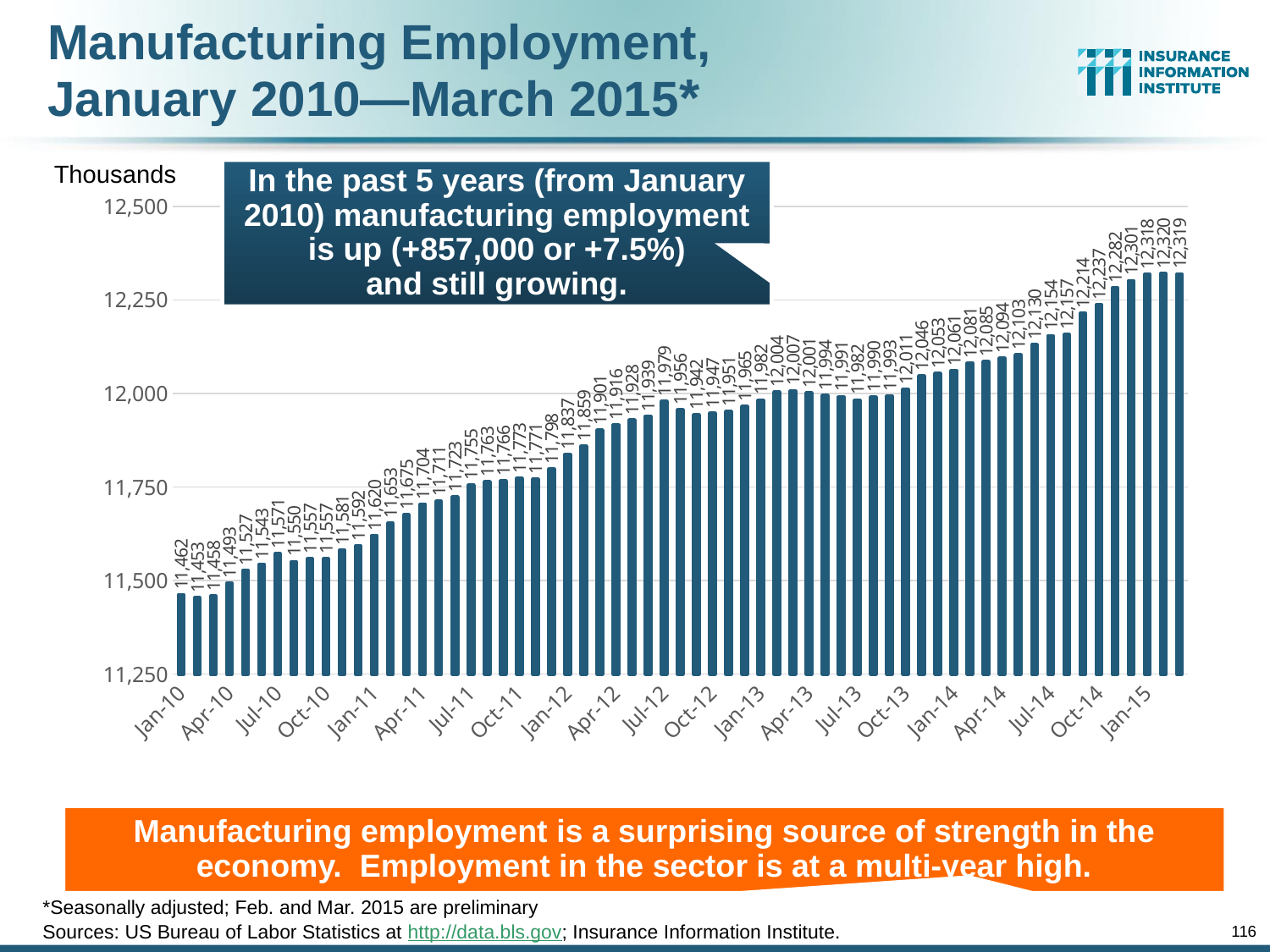
What kind of chart is shown on the slide? bar chart What is the difference between the last bar (March 2015, 12,319) and the first bar (Jan-10, 11,462)? 857 Which is larger, the value for Jan-15 or the value for Jan-10? Jan-15 What is the highest value labeled on the chart? 12,320 Is the value for Jan-11 greater or less than 11,750? less What is the value of the last bar on the chart (March 2015)? 12,319 What is the lowest value labeled on the chart? 11,453 What is the manufacturing employment value for Jan-15? 12,318 What unit is indicated for the vertical axis of the chart? Thousands What is the manufacturing employment value for Jan-10, the first bar on the chart? 11,462 Is the value for Jan-14 greater or less than 12,000? greater Do the values generally rise or fall from Jan-10 to Jan-15? rise